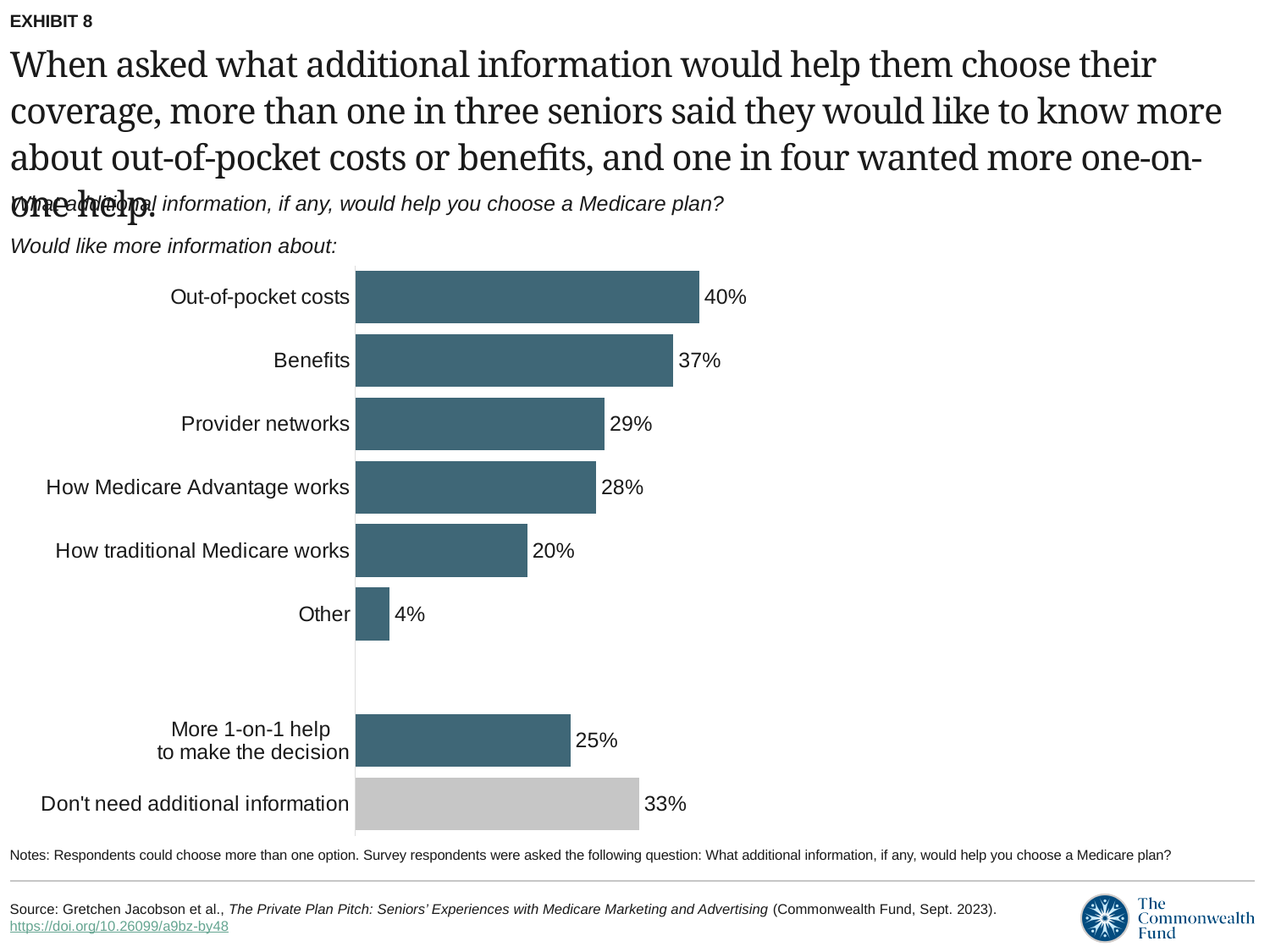
How many categories are shown in the chart? 8 What percentage of seniors would like more information about out-of-pocket costs? 40% What is the difference in percentage points between 'How Medicare Advantage works' and 'How traditional Medicare works'? 8 percentage points Which is larger: the percentage for 'Provider networks' or for 'How Medicare Advantage works'? Provider networks Which bar in the chart is shown in a different colour (grey) from the others? Don't need additional information What type of chart is shown on the slide? Bar chart What is the difference in percentage points between 'Out-of-pocket costs' and 'Benefits'? 3 percentage points What percentage of seniors wanted more 1-on-1 help to make the decision? 25% What percentage of seniors said they don't need additional information? 33% What percentage of seniors would like more information about provider networks? 29% Which category has the highest percentage in the chart? Out-of-pocket costs Which category has the lowest percentage in the chart? Other